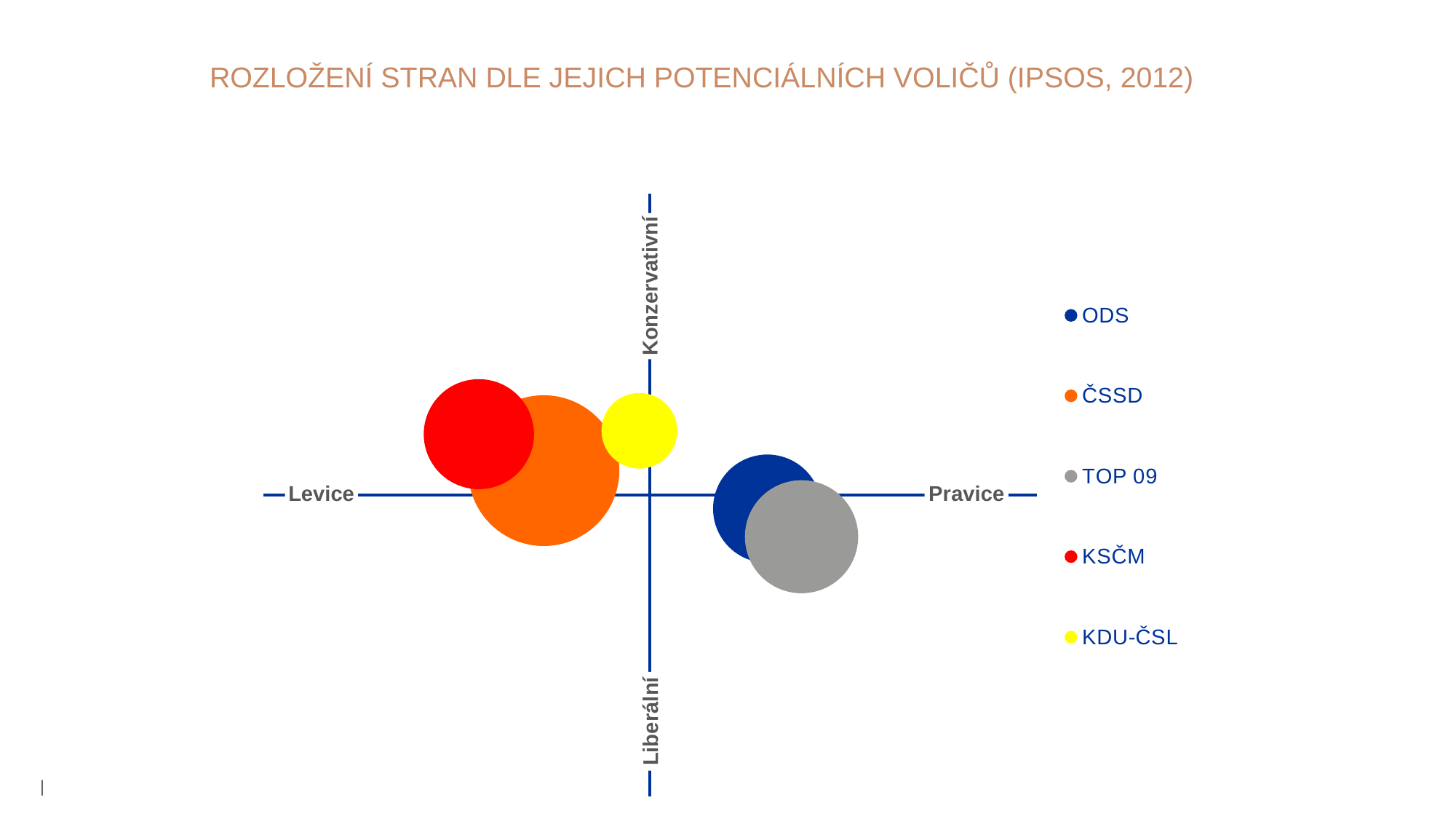
Which party's bubble is positioned furthest to the left (Levice) on the chart? KSČM Which party's bubble is positioned lowest (most Liberální) on the chart? TOP 09 Which bubble is larger, KSČM or KDU-ČSL? KSČM Which bubble is larger, ČSSD or ODS? ČSSD What kind of chart is shown on the slide? Bubble chart How many series does the legend list? 5 What is the title of the chart? ROZLOŽENÍ STRAN DLE JEJICH POTENCIÁLNÍCH VOLIČŮ (IPSOS, 2012) What colour is the bubble for KDU-ČSL? Yellow Which party has the smallest bubble on the chart? KDU-ČSL Which party has the largest bubble on the chart? ČSSD How many bubbles are plotted on the chart? 5 Which party's bubble is positioned furthest to the right (Pravice) on the chart? TOP 09